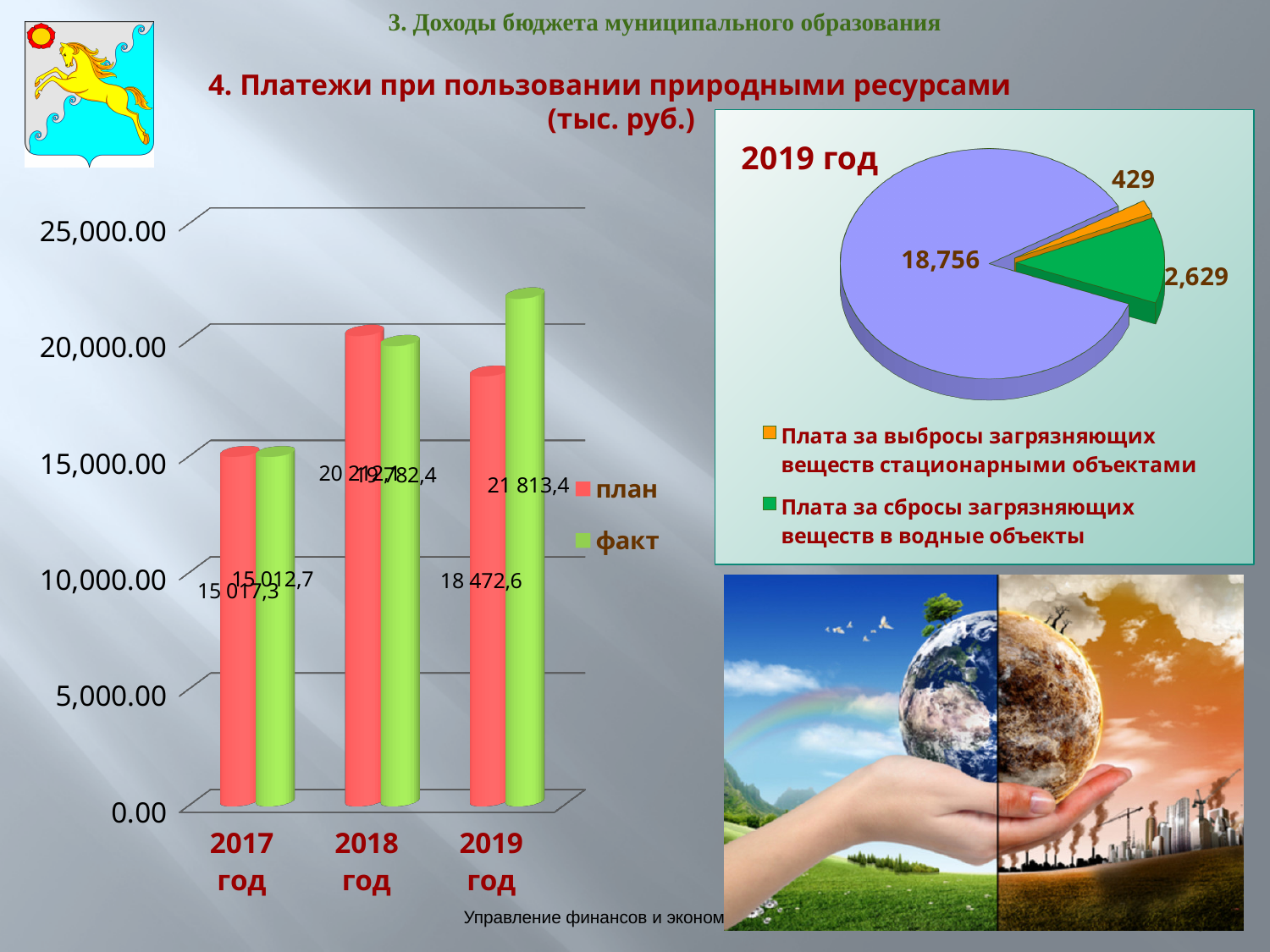
In the bar chart on the left, how many series does the legend list? 2 In the bar chart on the left, which is larger for 2019 год, план or факт? факт In the bar chart on the left, is the value of план for 2017 год greater or less than 10,000.00? greater What kind of chart is the chart on the left of the slide? bar chart In the bar chart on the left, what is the value of факт for 2019 год? 21 813,4 In the bar chart on the left, how many years are shown on the x axis? 3 In the bar chart on the left, what is the difference between факт and план for 2019 год? 3 340,8 In the pie chart titled 2019 год, what is the value of the slice for Плата за выбросы загрязняющих веществ стационарными объектами? 429 In the bar chart on the left, what is the value of план for 2017 год? 15 017,3 In the bar chart on the left, which year has the highest факт value? 2019 год In the pie chart titled 2019 год, what is the value of the slice for Плата за сбросы загрязняющих веществ в водные объекты? 2,629 In the bar chart on the left, what is the value of план for 2019 год? 18 472,6